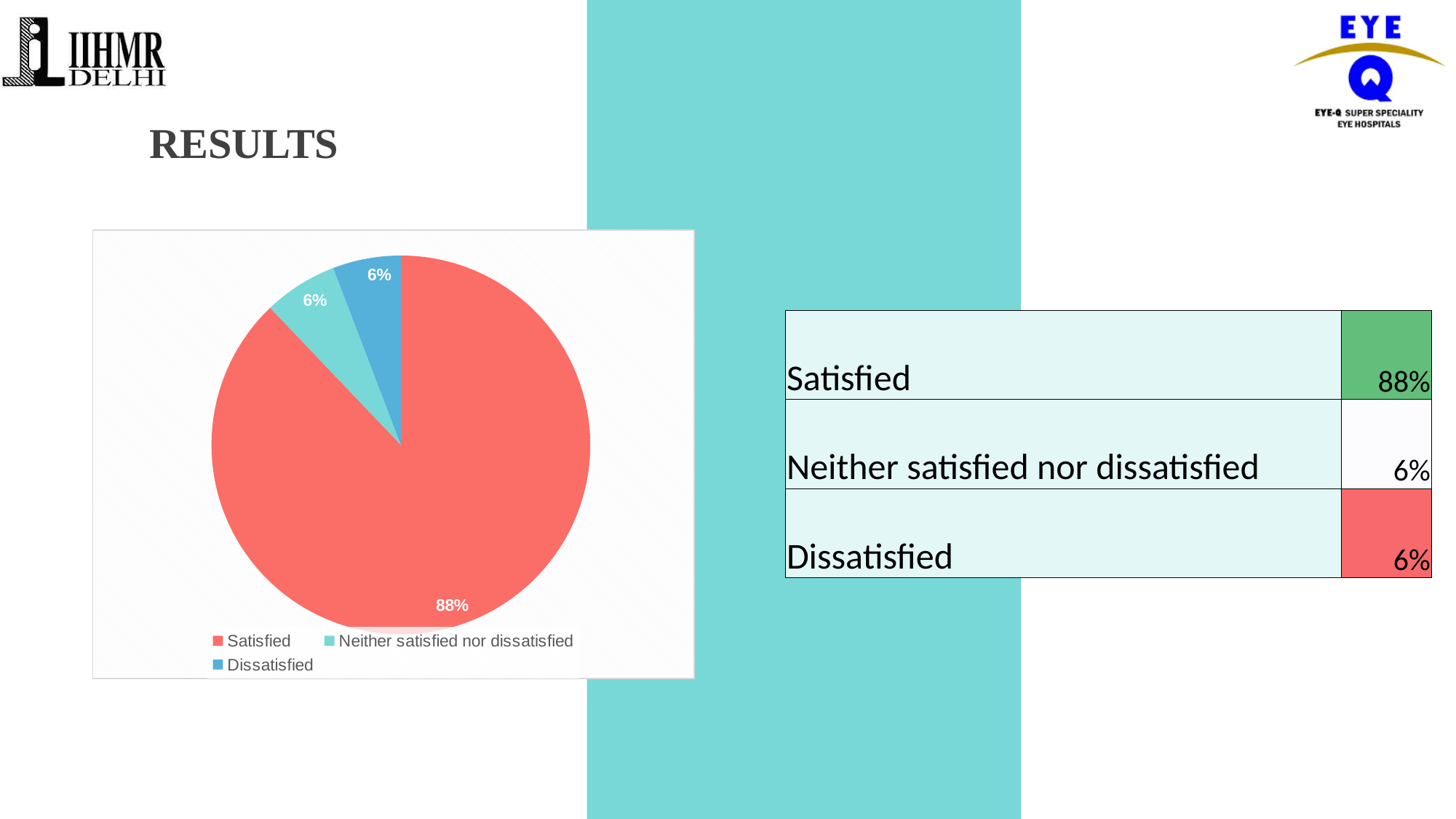
What is the combined share of the Neither satisfied nor dissatisfied and Dissatisfied slices? 12% Which is larger, the Satisfied slice or the Neither satisfied nor dissatisfied slice? Satisfied Which category has the largest slice of the pie? Satisfied What colour is the Satisfied slice in the pie chart? red What colour is the Dissatisfied slice in the pie chart? blue What is the value shown for Dissatisfied? 6% What share of the pie does the Satisfied slice represent? 88% How many slices does the pie chart have? 3 What is the difference between the Satisfied and Dissatisfied values? 82% What type of chart is shown on the slide? pie chart What is the value shown for Neither satisfied nor dissatisfied? 6% How many entries does the legend list? 3